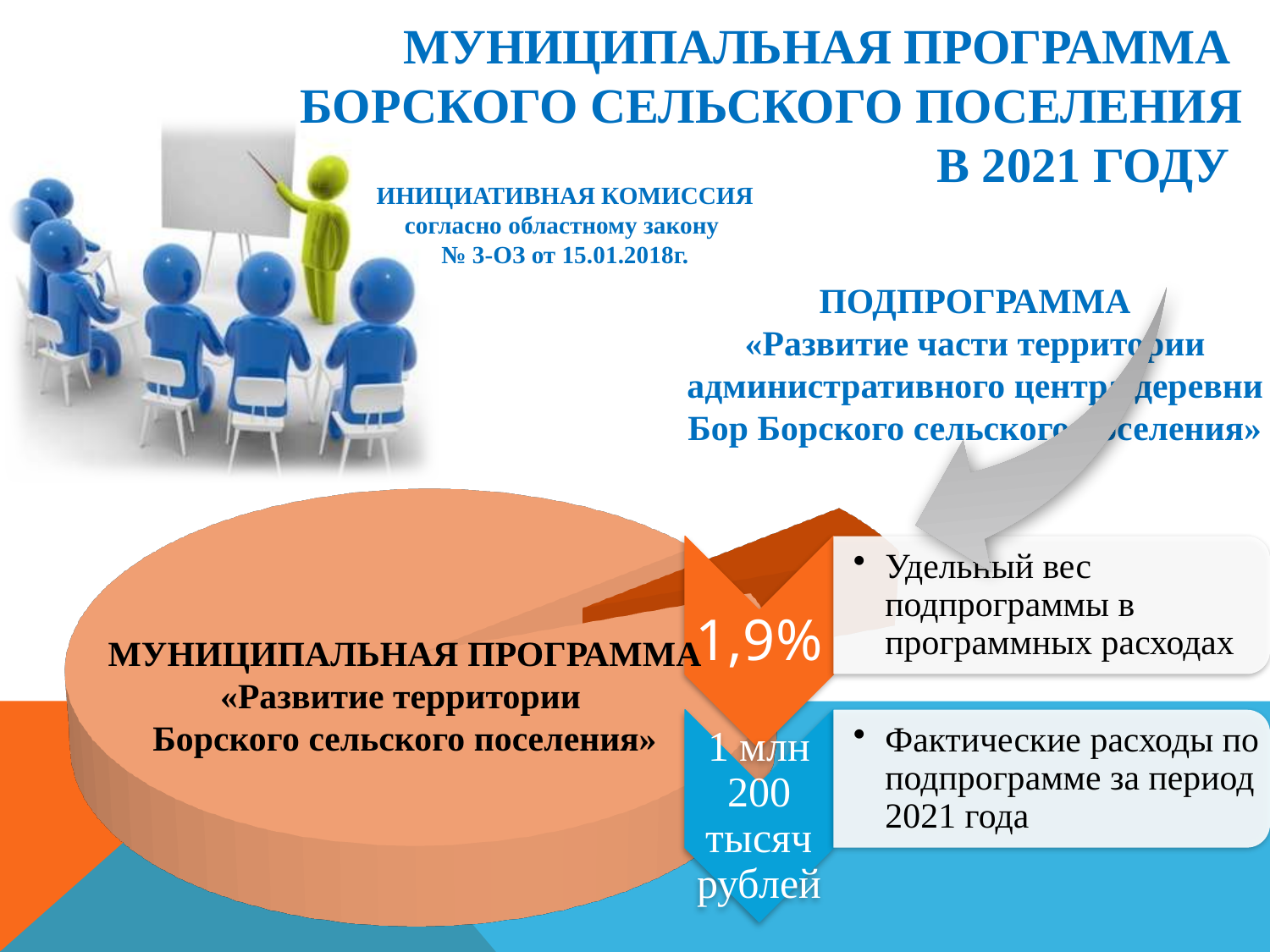
How many slices does the pie chart have? 2 What share of the pie does the subprogram «Развитие части территории административного центра деревни Бор Борского сельского поселения» take, according to the label next to the small slice? 1,9% Is the share of the small exploded slice greater or less than 50%? less What colour is the small exploded slice of the pie chart? Orange What kind of chart is shown on the slide? Pie chart Which slice of the pie is larger: the one for the municipal program «Развитие территории Борского сельского поселения» or the small exploded slice for the subprogram? МУНИЦИПАЛЬНАЯ ПРОГРАММА «Развитие территории Борского сельского поселения» What amount of actual expenditure for the subprogram in 2021 is shown next to the pie chart? 1 млн 200 тысяч рублей What label is written on the large slice of the pie chart? МУНИЦИПАЛЬНАЯ ПРОГРАММА «Развитие территории Борского сельского поселения»